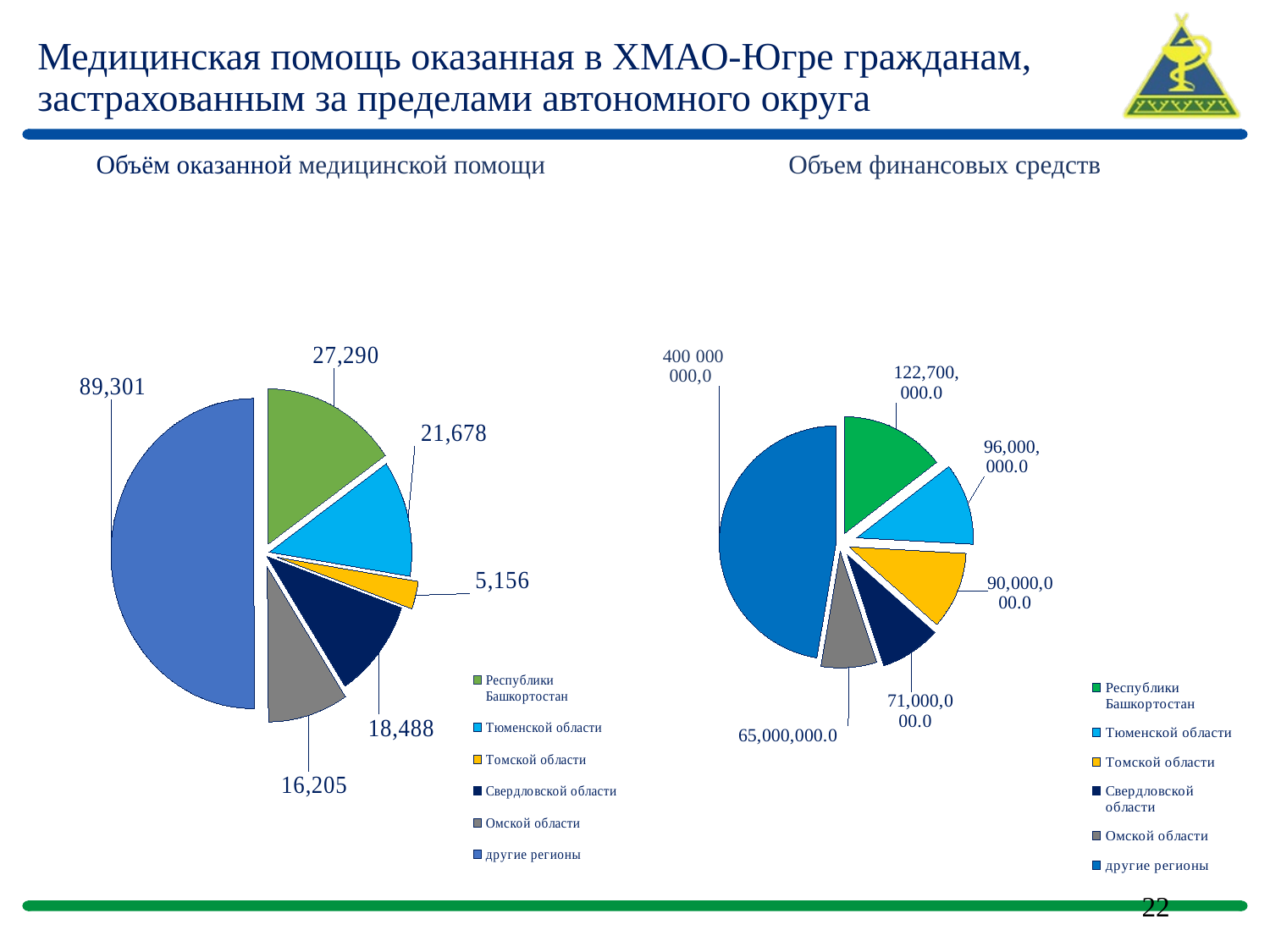
In the "Объём оказанной медицинской помощи" chart, which category has the largest slice? другие регионы In the "Объем финансовых средств" chart, what colour is the slice for Томской области? yellow In the "Объём оказанной медицинской помощи" chart, which category has the smallest slice? Томской области How many categories does the "Объем финансовых средств" chart show? 6 In the "Объём оказанной медицинской помощи" chart, what is the value for Республики Башкортостан? 27,290 In the "Объём оказанной медицинской помощи" chart, what is the value for Томской области? 5,156 In the "Объем финансовых средств" chart, what is the value for Республики Башкортостан? 122,700,000.0 What type of chart is used for "Объём оказанной медицинской помощи"? pie chart In the "Объём оказанной медицинской помощи" chart, which is larger: Свердловской области or Омской области? Свердловской области In the "Объём оказанной медицинской помощи" chart, what is the difference between the values for Республики Башкортостан and Тюменской области? 5,612 In the "Объем финансовых средств" chart, what is the value for Омской области? 65,000,000.0 In the "Объем финансовых средств" chart, which category has the largest slice? другие регионы